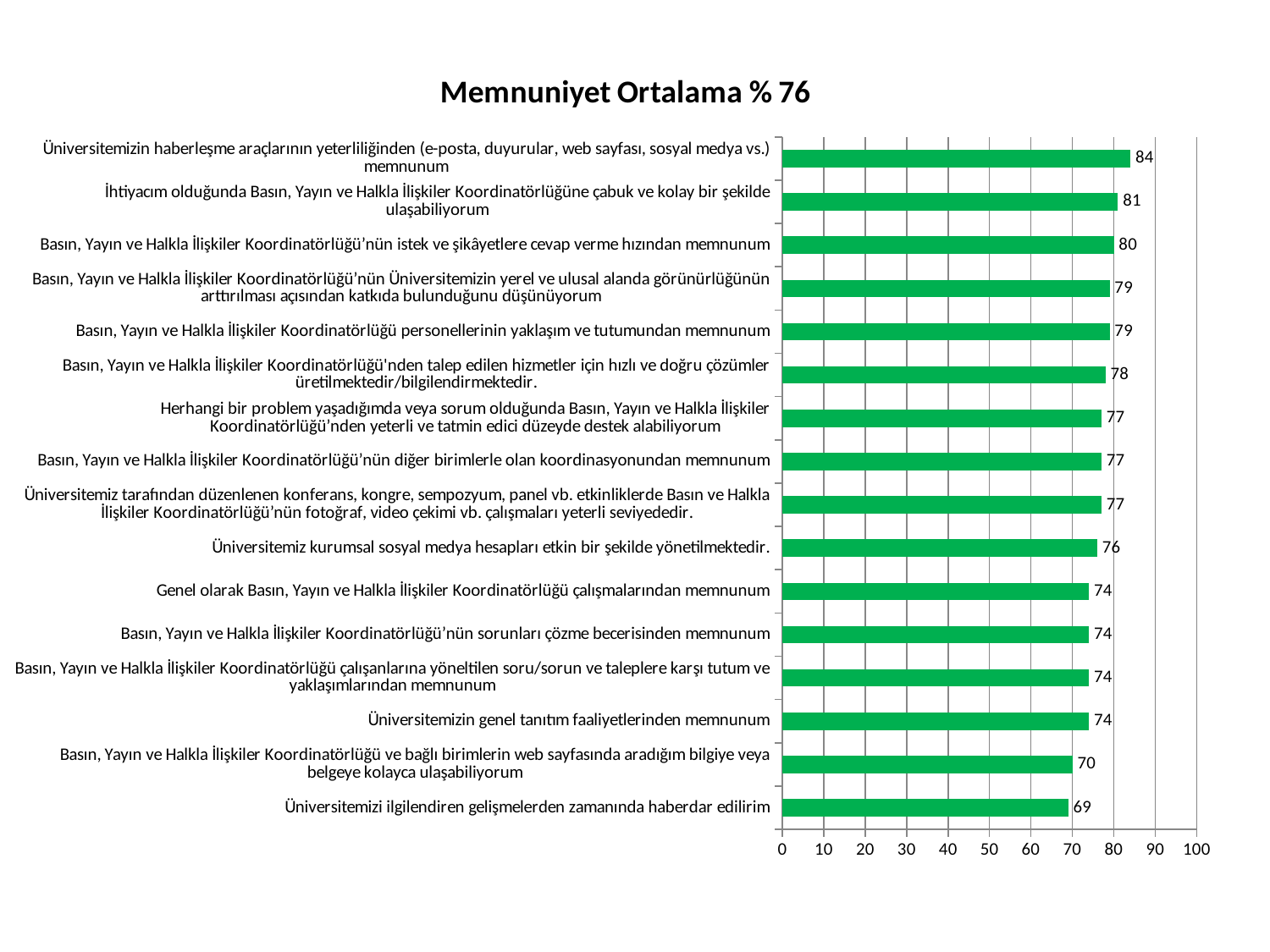
What is the value for "Üniversitemiz kurumsal sosyal medya hesapları etkin bir şekilde yönetilmektedir."? 76 What is the value for "Basın, Yayın ve Halkla İlişkiler Koordinatörlüğü personellerinin yaklaşım ve tutumundan memnunum"? 79 How many bars (categories) does the chart show? 16 What is the value for "Üniversitemizin genel tanıtım faaliyetlerinden memnunum"? 74 What is the title of the chart? Memnuniyet Ortalama % 76 What is the value for "Basın, Yayın ve Halkla İlişkiler Koordinatörlüğü ve bağlı birimlerin web sayfasında aradığım bilgiye veya belgeye kolayca ulaşabiliyorum"? 70 Which category has the highest value? Üniversitemizin haberleşme araçlarının yeterliliğinden (e-posta, duyurular, web sayfası, sosyal medya vs.) memnunum Which category has the lowest value? Üniversitemizi ilgilendiren gelişmelerden zamanında haberdar edilirim Is the value for "Basın, Yayın ve Halkla İlişkiler Koordinatörlüğü'nün istek ve şikâyetlere cevap verme hızından memnunum" greater or less than 70? greater What is the difference between the highest value (84) and the lowest value (69)? 15 What type of chart is shown on the slide? bar chart Which is larger: the value for "İhtiyacım olduğunda Basın, Yayın ve Halkla İlişkiler Koordinatörlüğüne çabuk ve kolay bir şekilde ulaşabiliyorum" or the value for "Genel olarak Basın, Yayın ve Halkla İlişkiler Koordinatörlüğü çalışmalarından memnunum"? İhtiyacım olduğunda Basın, Yayın ve Halkla İlişkiler Koordinatörlüğüne çabuk ve kolay bir şekilde ulaşabiliyorum